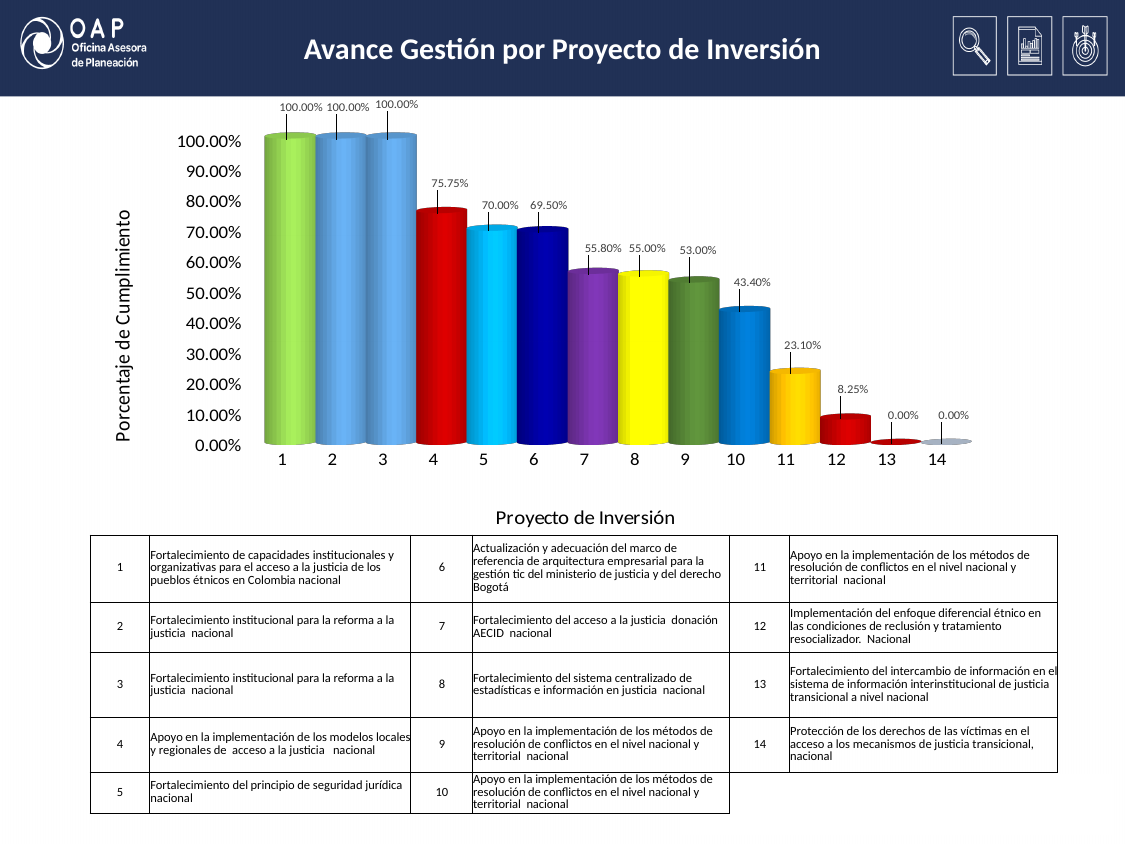
What is the difference between the values for project 5 and project 6? 0.50% Is the value for project 11 greater or less than 30.00%? less What is the difference between the values for project 11 and project 12? 14.85% How many projects (categories) are plotted on the x axis? 14 Which has a larger value, project 9 or project 10? Project 9 What is the value for project 7 in the chart? 55.80% What is the value for project 4 in the chart? 75.75% What is the value for project 12 in the chart? 8.25% What is the label of the y axis? Porcentaje de Cumplimiento Do the values generally rise or fall from project 1 to project 14? Fall What type of chart is shown on the slide? Bar chart What is the value for project 10 in the chart? 43.40%